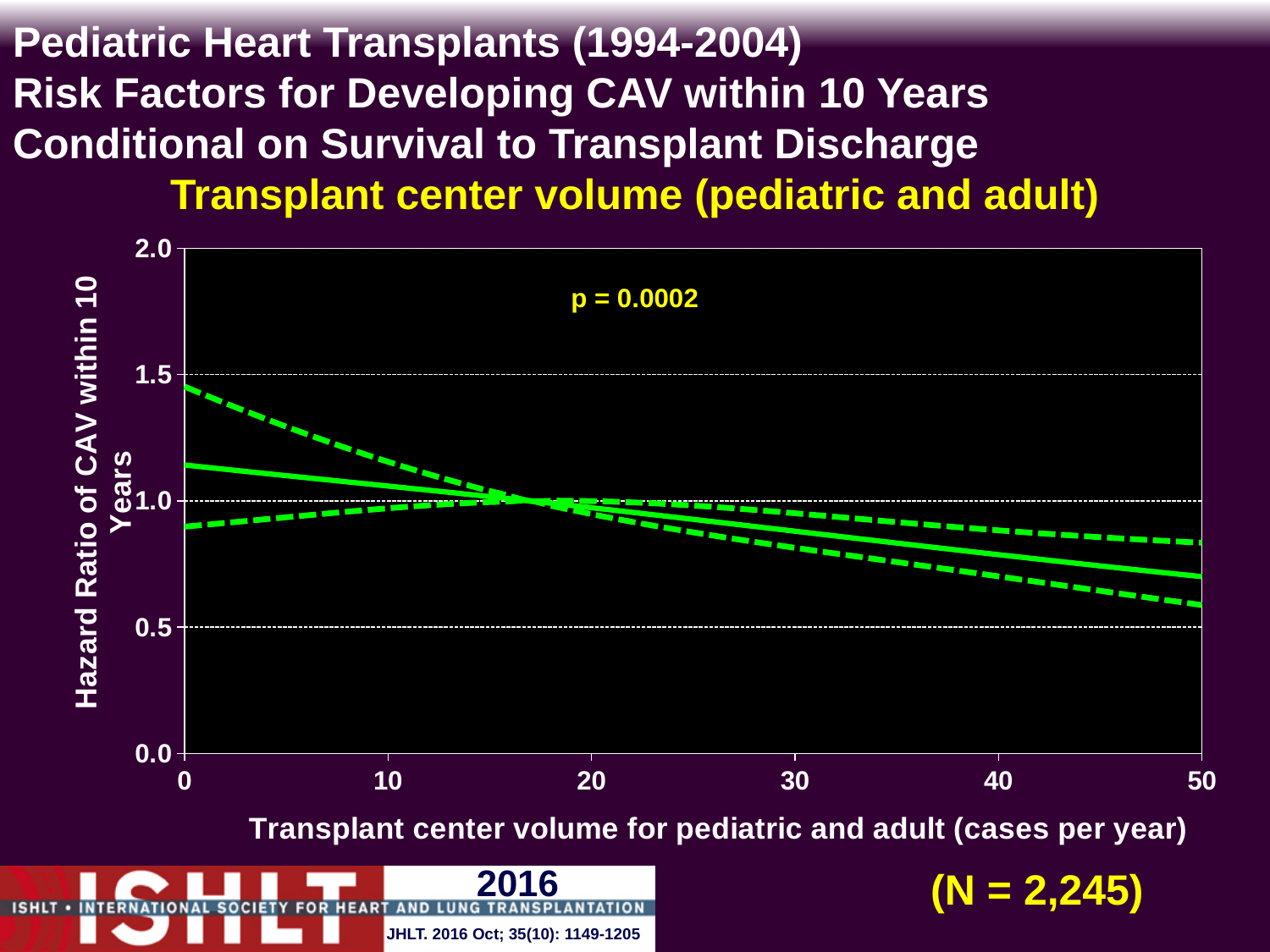
What p-value is printed on the chart? p = 0.0002 How many lines are plotted on the chart? 3 What is the sample size (N) shown on the slide? N = 2,245 Is the solid line at a transplant center volume of 40 cases per year greater or less than 1.0? less Does the solid hazard ratio line rise or fall as transplant center volume increases from 0 to 50 cases per year? Fall Is the hazard ratio on the solid line at a transplant center volume of 0 cases per year greater or less than 1.0? greater Is the lower dashed line at a transplant center volume of 50 cases per year greater or less than 0.5? greater What kind of chart is shown on the slide? Line chart What is the maximum value shown on the y axis of the chart? 2.0